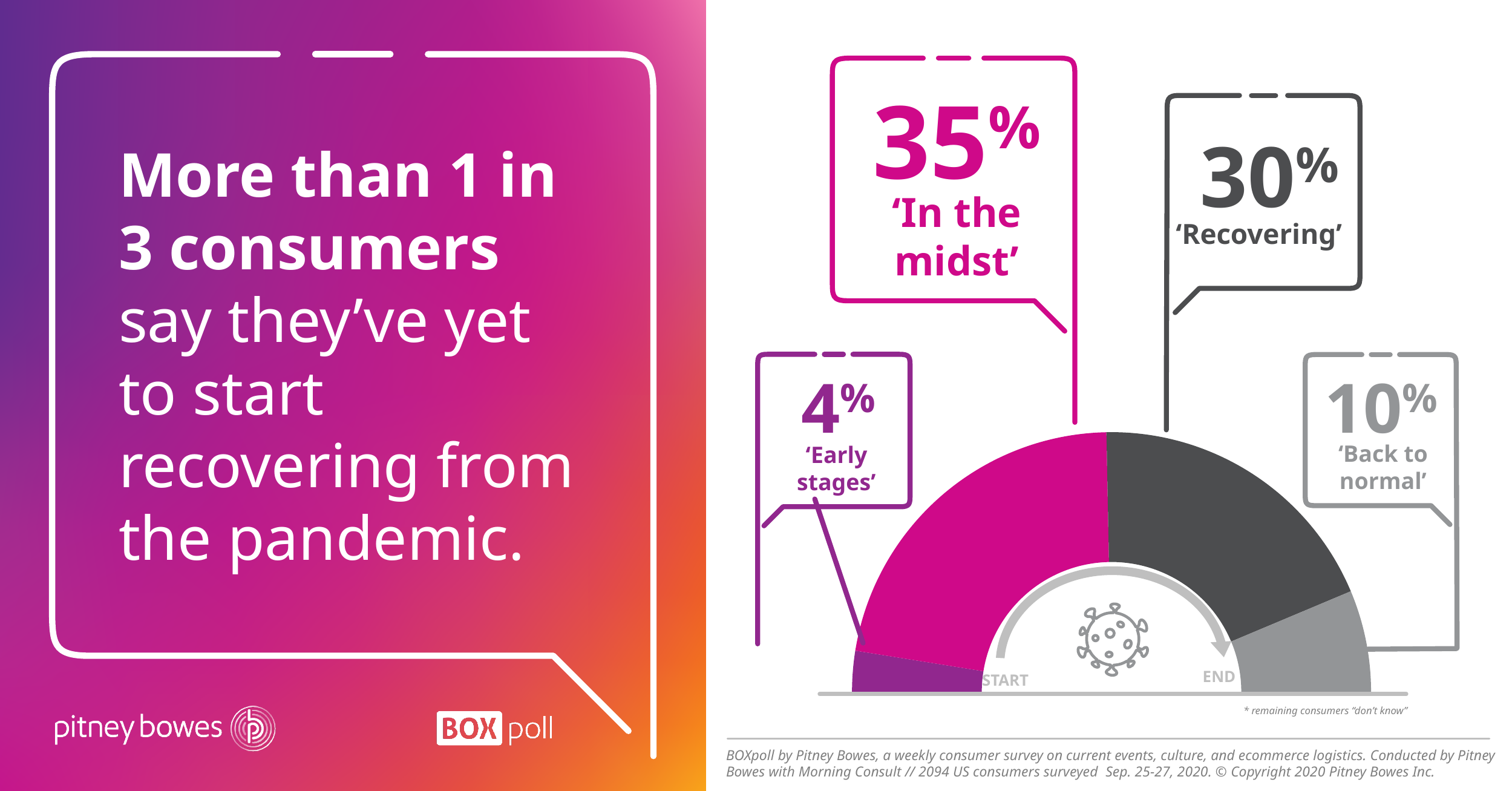
What is the difference in percentage points between 'Back to normal' and 'Early stages'? 6 What percentage of consumers say they are in the 'Early stages'? 4% What percentage of consumers say they are 'Recovering'? 30% What is the difference in percentage points between 'In the midst' and 'Recovering'? 5 How many labelled categories are shown on the semicircular chart? 4 According to the footnote, what do the remaining consumers not shown in the chart answer? "don't know" Which is larger, the share for 'Recovering' or the share for 'Back to normal'? 'Recovering' What colour is the 'In the midst' segment of the chart? Magenta What percentage of consumers say they are 'In the midst' of the pandemic? 35% What percentage of consumers say they are 'Back to normal'? 10% Which category has the lowest percentage? 'Early stages' Which category has the highest percentage? 'In the midst'